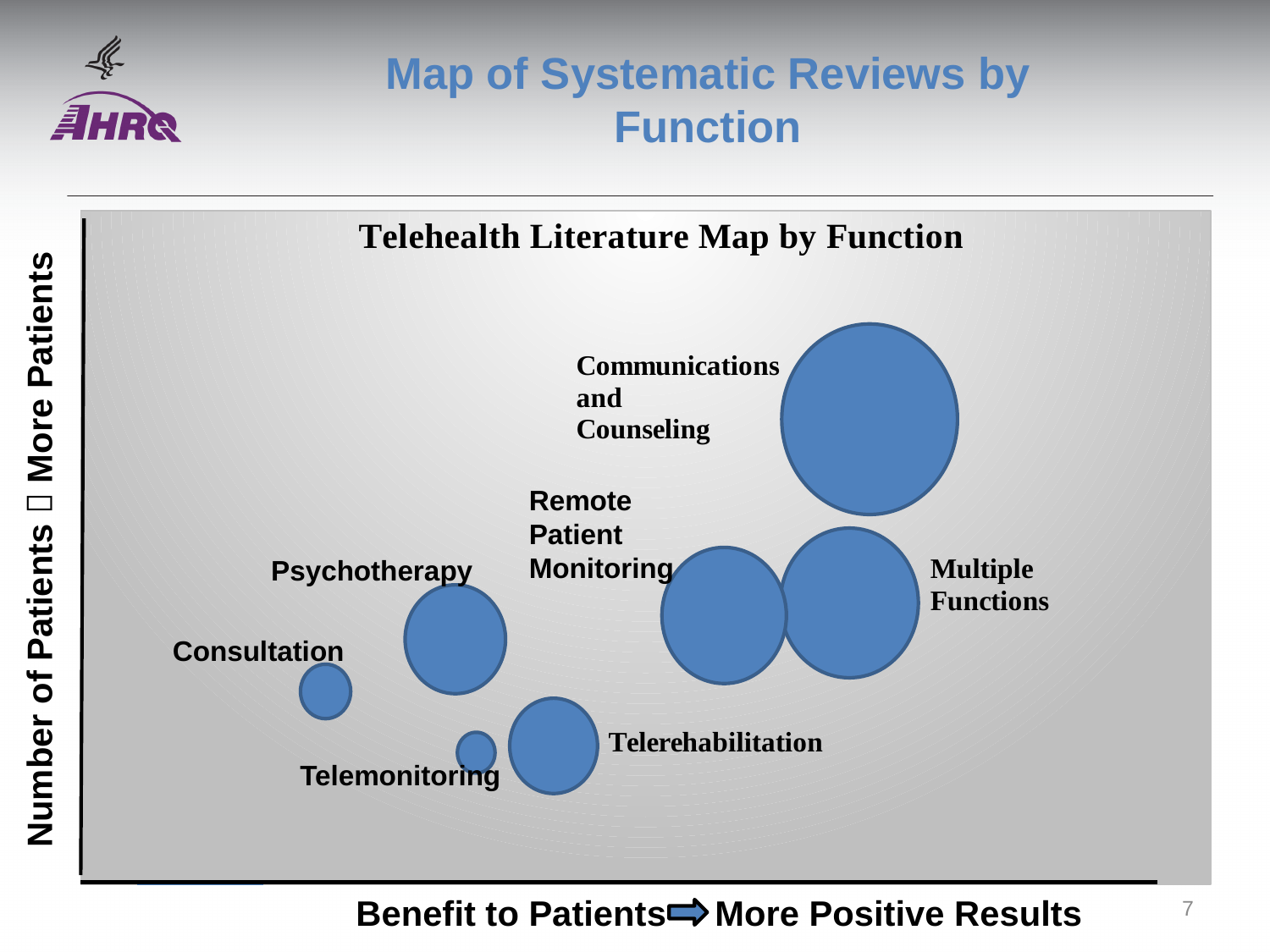
Do the bubbles generally rise or fall in Number of Patients as Benefit to Patients increases along the x axis? Rise What does the horizontal axis of the chart represent? Benefit to Patients (More Positive Results) Which function is plotted highest on the vertical axis (Number of Patients)? Communications and Counseling What kind of chart is shown on the slide? Bubble chart Which bubble is larger, Psychotherapy or Consultation? Psychotherapy Which function is plotted furthest to the left on the horizontal axis (Benefit to Patients)? Consultation What is the title of the chart? Telehealth Literature Map by Function Which bubble is larger, Telerehabilitation or Telemonitoring? Telerehabilitation How many bubbles (functions) are plotted on the chart? 7 Which function has the largest bubble on the chart? Communications and Counseling Which is plotted further to the right on the horizontal axis, Multiple Functions or Psychotherapy? Multiple Functions Which function has the smallest bubble on the chart? Telemonitoring